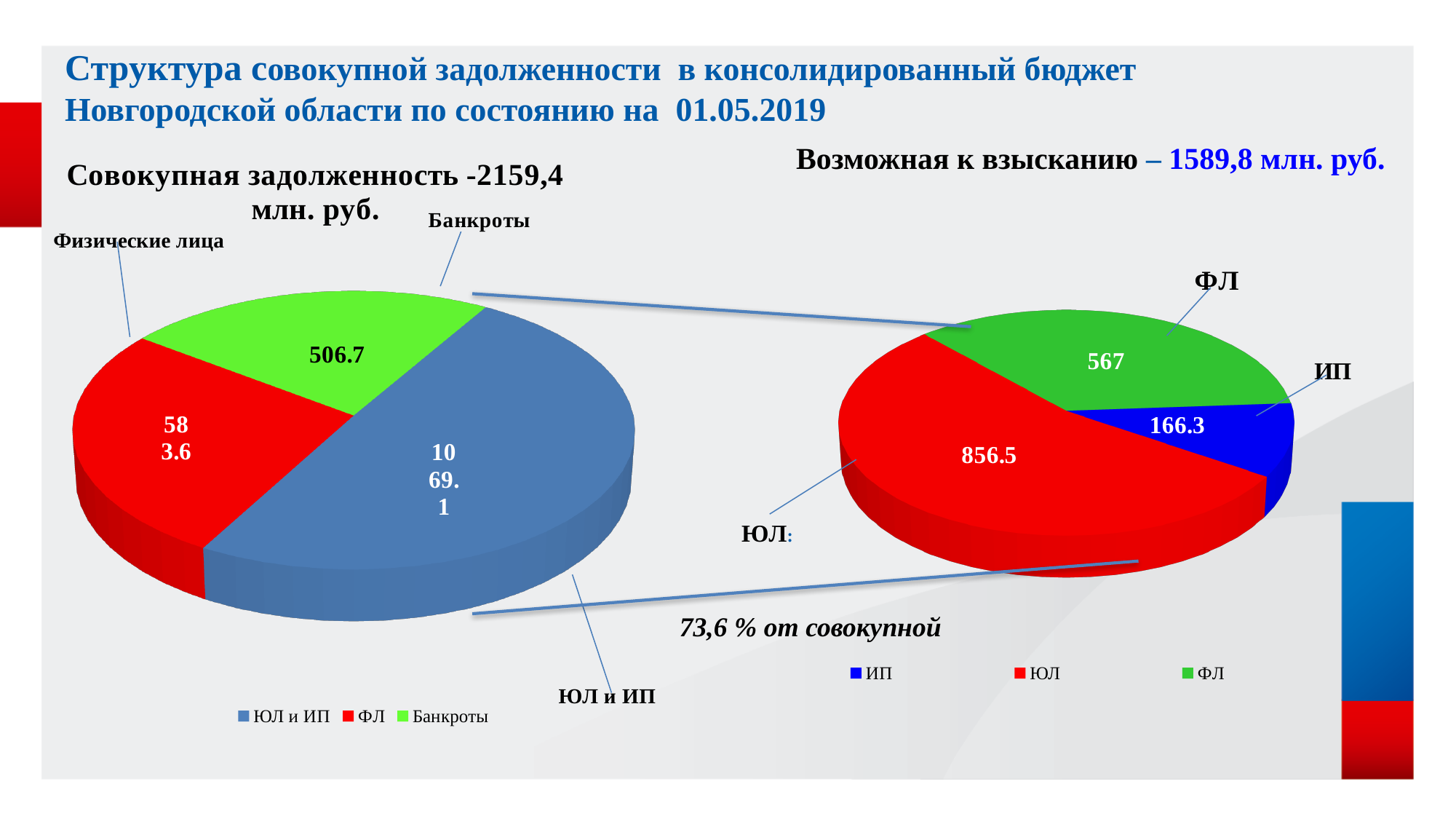
In the left pie chart (Совокупная задолженность), what is the value for Банкроты? 506.7 In the left pie chart (Совокупная задолженность), what is the value for ЮЛ и ИП? 1069.1 In the left pie chart (Совокупная задолженность), what is the difference between the values for ЮЛ и ИП and ФЛ? 485.5 In the right pie chart (Возможная к взысканию), what is the difference between the values for ЮЛ and ФЛ? 289.5 In the right pie chart (Возможная к взысканию), what is the value for ИП? 166.3 In the right pie chart (Возможная к взысканию), which category has the largest slice? ЮЛ In the left pie chart (Совокупная задолженность), what colour is the Банкроты slice? Green In the left pie chart (Совокупная задолженность), which is larger: ФЛ or Банкроты? ФЛ In the right pie chart (Возможная к взысканию), what is the value for ФЛ? 567 How many slices does the right pie chart (Возможная к взысканию) have? 3 What type of chart is used on the left side of the slide (Совокупная задолженность)? Pie chart In the left pie chart (Совокупная задолженность), which category has the smallest slice? Банкроты